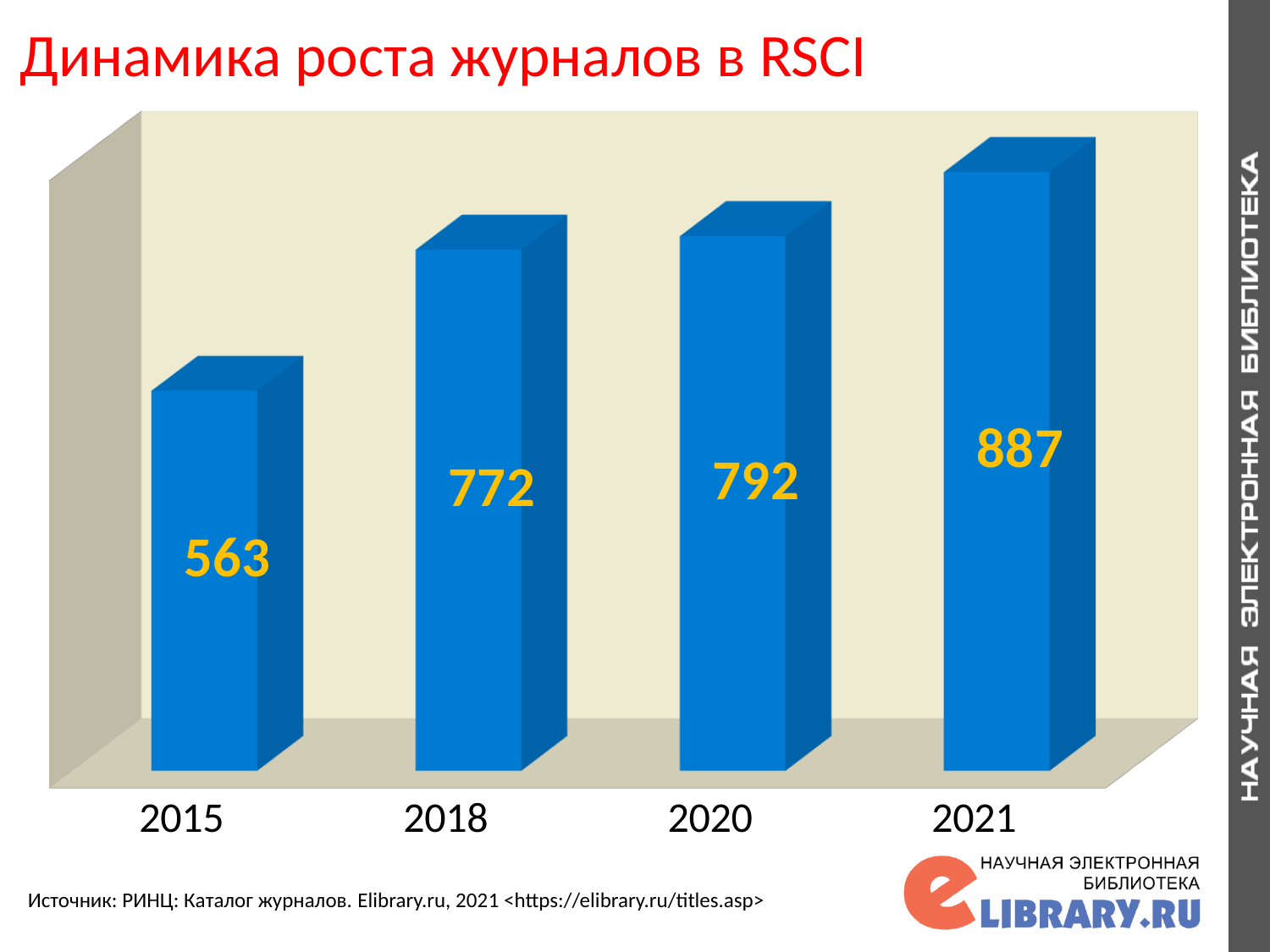
What is the value for 2015? 563 What is the difference between the values for 2020 and 2018? 20 Do the values rise or fall from 2015 to 2021? Rise Which year has the highest value? 2021 What is the value for 2020? 792 What kind of chart is shown on the slide? Bar chart Which year has the lowest value? 2015 Which is larger, the value for 2018 or the value for 2015? 2018 What is the value for 2018? 772 How many years are shown on the chart? 4 What is the value for 2021? 887 What is the difference between the values for 2021 and 2015? 324